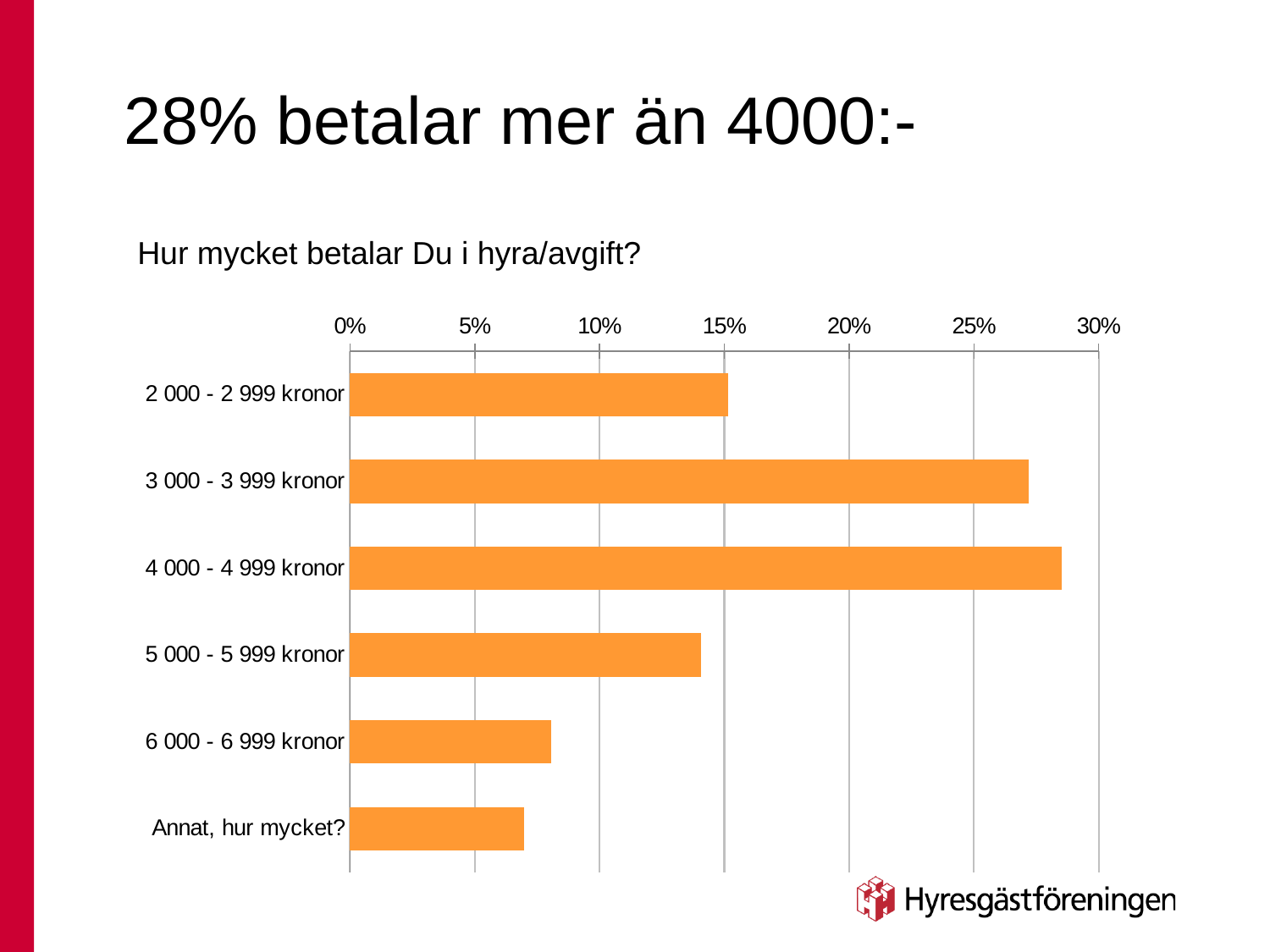
Is the value for 5 000 - 5 999 kronor greater or less than 15%? less How many categories are shown in the chart? 6 Which is larger, the value for 3 000 - 3 999 kronor or the value for 5 000 - 5 999 kronor? 3 000 - 3 999 kronor Is the value for 2 000 - 2 999 kronor greater or less than 10%? greater What colour are the bars in the chart? orange Is the value for 6 000 - 6 999 kronor greater or less than 10%? less Which category has the highest value in the chart? 4 000 - 4 999 kronor What kind of chart is shown on the slide? bar chart What question is the chart titled with? Hur mycket betalar Du i hyra/avgift? Which is larger, the value for 2 000 - 2 999 kronor or the value for 6 000 - 6 999 kronor? 2 000 - 2 999 kronor